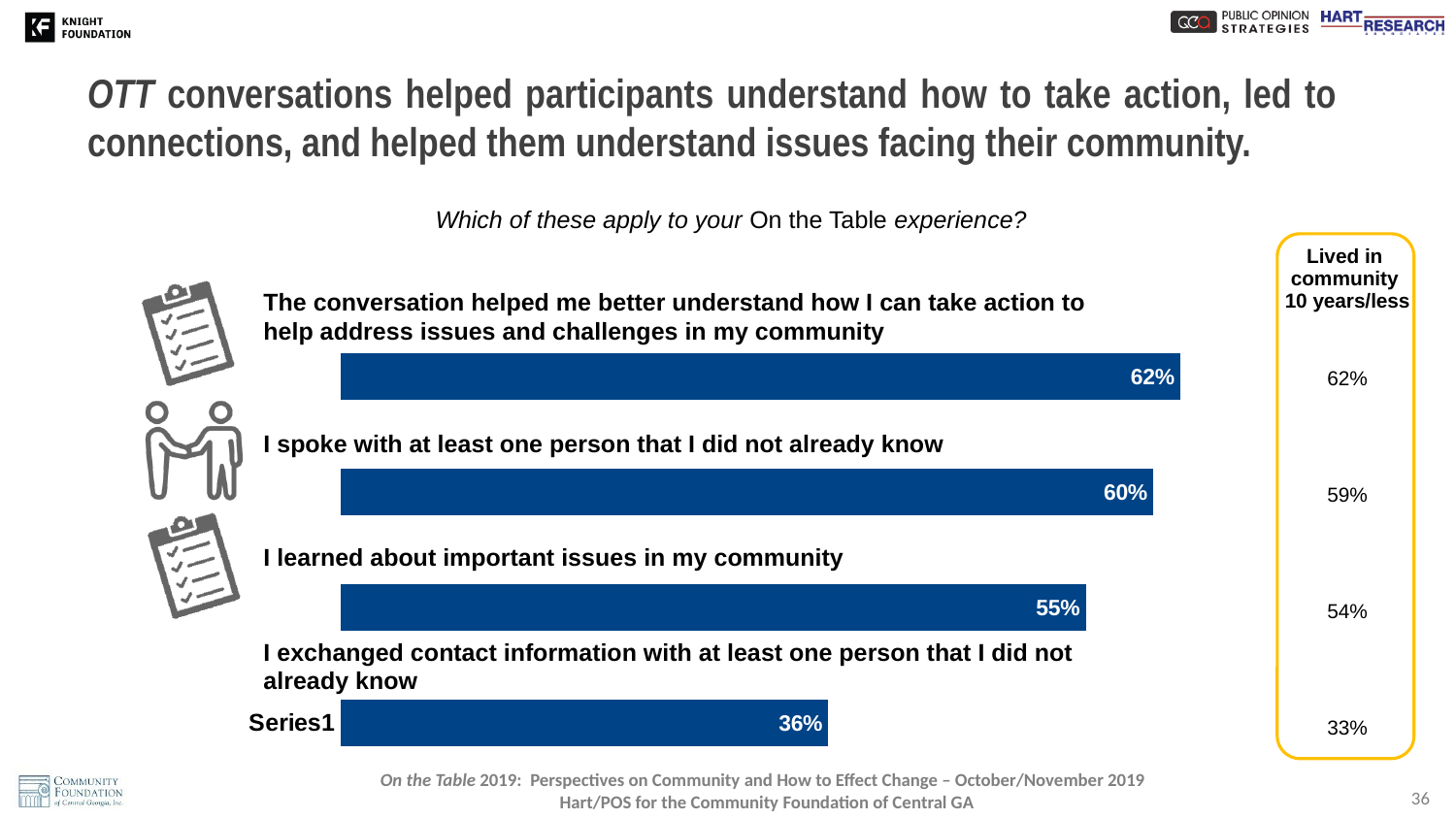
What is the difference in percentage points between the highest bar (62%) and 'I learned about important issues in my community'? 7 percentage points How many statements (bars) are shown in the chart? 4 Which statement has the highest percentage of participants saying it applied to their On the Table experience? The conversation helped me better understand how I can take action to help address issues and challenges in my community What type of chart is used on this slide? Bar chart In the 'Lived in community 10 years/less' column on the right, what percentage is shown for 'I exchanged contact information with at least one person that I did not already know'? 33% Which is larger: the percentage for 'I learned about important issues in my community' or the percentage for 'I exchanged contact information with at least one person that I did not already know'? I learned about important issues in my community What percentage of participants said they exchanged contact information with at least one person they did not already know? 36% What percentage of participants said they learned about important issues in their community? 55% What percentage of participants said the conversation helped them better understand how they can take action to help address issues and challenges in their community? 62% Which statement has the lowest percentage of participants saying it applied to their On the Table experience? I exchanged contact information with at least one person that I did not already know What percentage of participants said they spoke with at least one person they did not already know? 60% What is the difference in percentage points between 'I spoke with at least one person that I did not already know' and 'I exchanged contact information with at least one person that I did not already know'? 24 percentage points